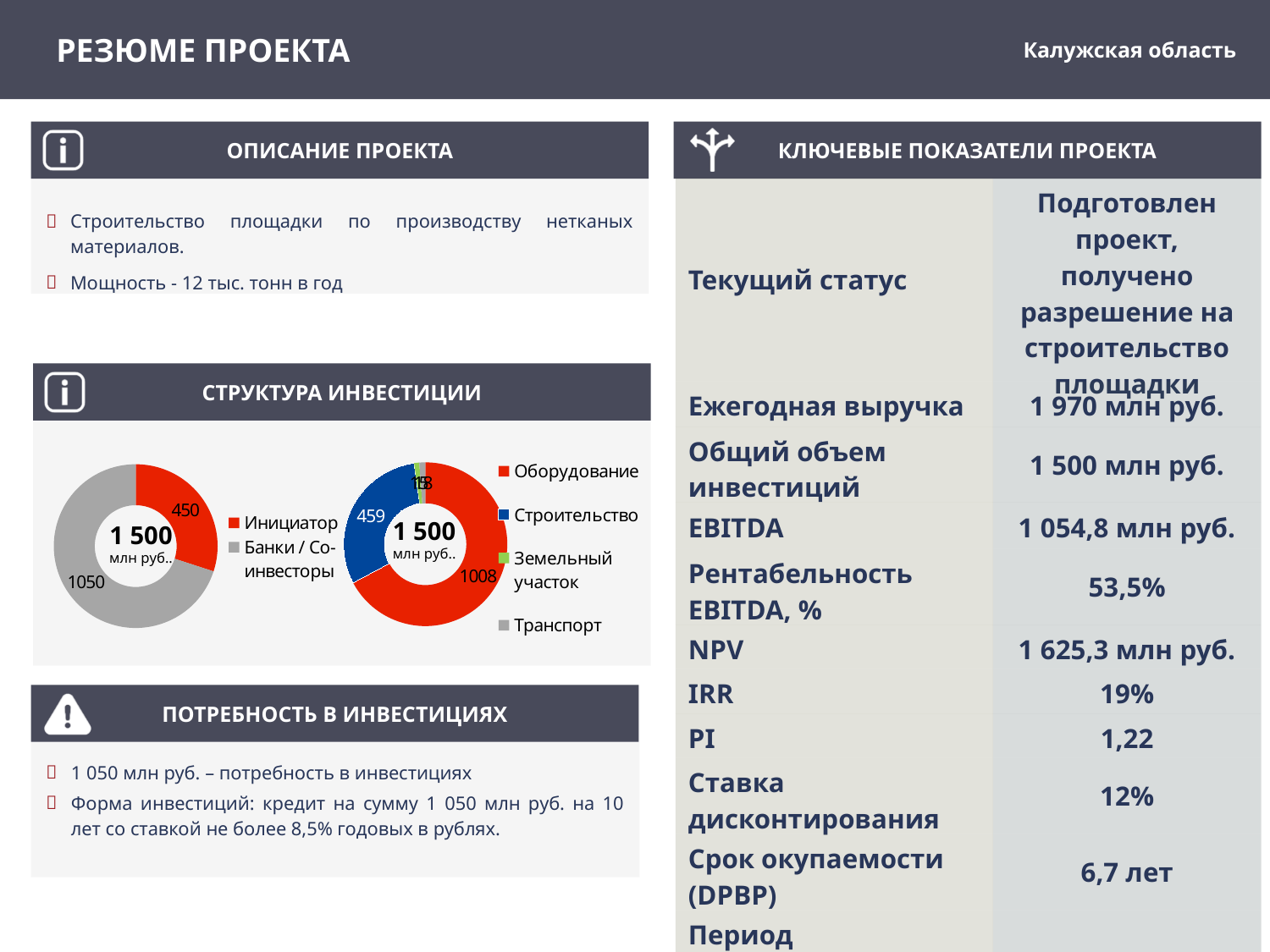
In the right donut chart (Оборудование / Строительство), which is larger: Оборудование or Строительство? Оборудование In the left donut chart (Инициатор / Банки), what share of the total does Инициатор represent? 30% In the left donut chart (Инициатор / Банки), which category has the largest value? Банки / Со-инвесторы In the left donut chart (Инициатор / Банки), what is the value for Инициатор? 450 In the left donut chart (Инициатор / Банки), what total is shown in the centre of the donut? 1 500 млн руб. In the right donut chart (Оборудование / Строительство), how many categories does the legend list? 4 In the right donut chart (Оборудование / Строительство), what is the value for Оборудование? 1008 In the right donut chart (Оборудование / Строительство), which category has the largest value? Оборудование In the right donut chart (Оборудование / Строительство), what is the value for Строительство? 459 What type of chart is used in the СТРУКТУРА ИНВЕСТИЦИИ section? Donut (pie) chart In the left donut chart (Инициатор / Банки), what is the difference between Банки / Со-инвесторы and Инициатор? 600 In the left donut chart (Инициатор / Банки), what is the value for Банки / Со-инвесторы? 1050